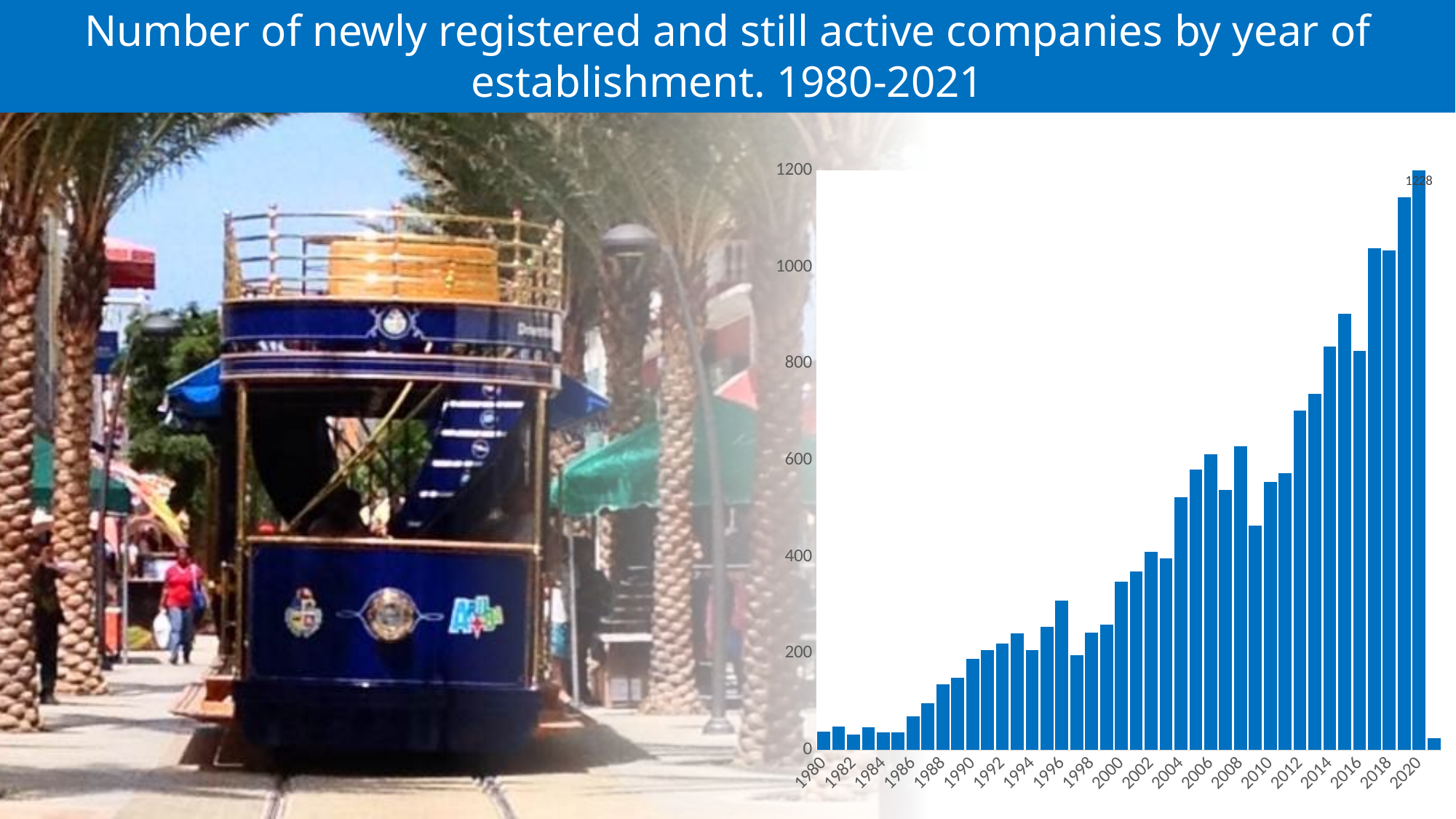
Is the value for 2009 greater or less than 600? less What is the title of the chart on the slide? Number of newly registered and still active companies by year of establishment. 1980-2021 How many years (bars) are plotted in the chart? 42 Is the value for 1986 greater or less than 200? less Which year has the highest number of newly registered and still active companies? 2020 What is the value shown for the year 2020? 1228 Do the values generally rise or fall from 1980 to 2020? rise Is the value for 2019 greater or less than 1000? greater Which year has the larger value, 2007 or 2008? 2008 What kind of chart is shown on the slide? bar chart Which year has the larger value, 1996 or 1997? 1996